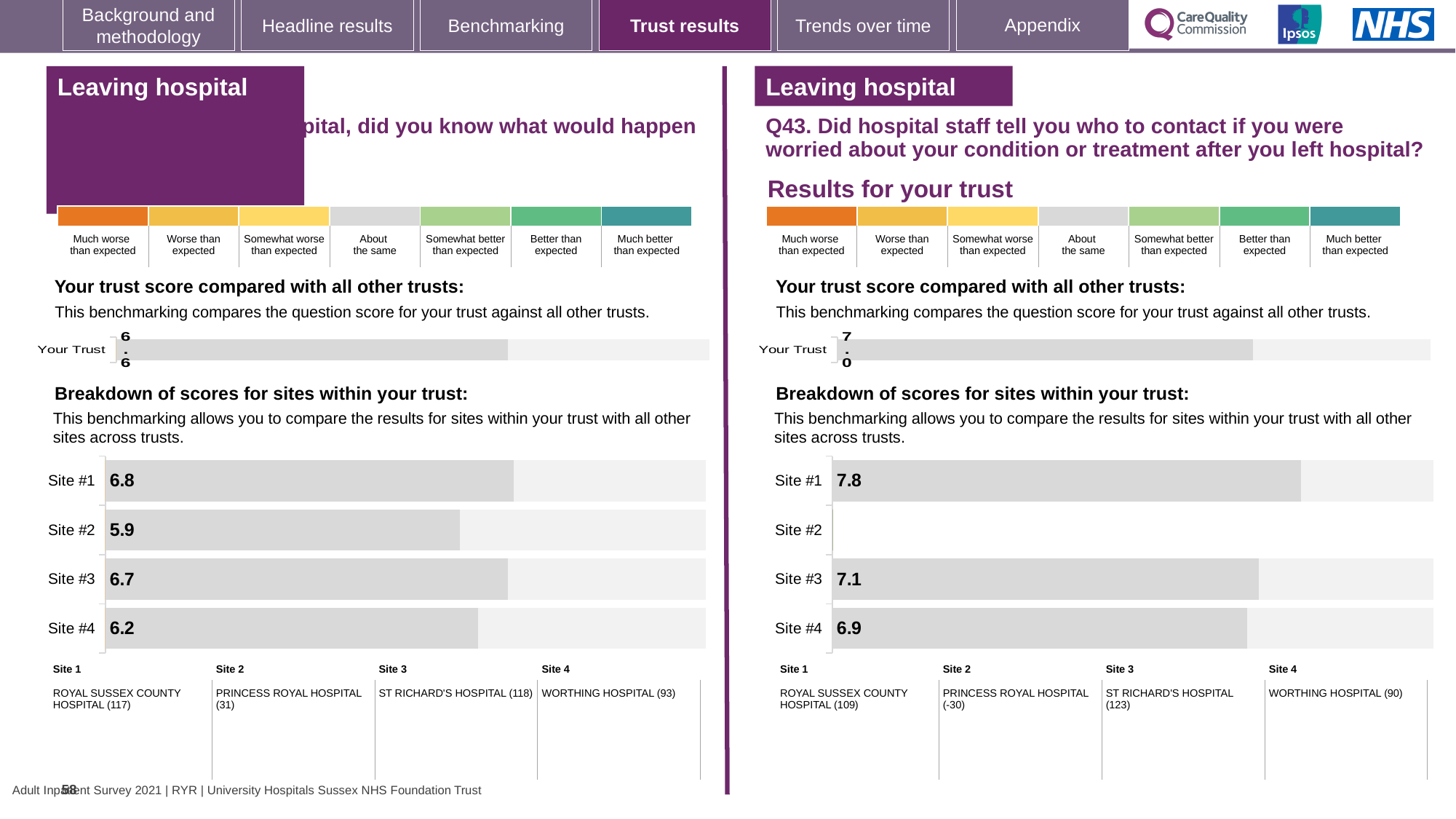
On the left-hand panel's 'Your trust score compared with all other trusts' chart, what is the score for Your Trust? 6.6 On the left-hand panel's site breakdown chart, which site has the highest score? Site #1 On the right-hand panel (Q43) site breakdown chart, which site has the highest score? Site #1 What type of chart is used for the site breakdown on the right-hand panel (Q43)? Bar chart On the right-hand panel (Q43) site breakdown chart, which is larger: the score for Site #3 or Site #4? Site #3 On the left-hand panel's site breakdown chart, what is the difference between the scores for Site #1 and Site #2? 0.9 On the right-hand panel (Q43) site breakdown chart, what is the difference between the scores for Site #1 and Site #4? 0.9 On the left-hand panel's site breakdown chart, which site has the lowest score? Site #2 How many sites are listed on the left-hand panel's site breakdown chart? 4 On the right-hand panel (Q43), what is the score for Your Trust in the 'Your trust score compared with all other trusts' chart? 7.0 On the left-hand panel's 'Breakdown of scores for sites within your trust' chart, what is the score for Site #1? 6.8 On the right-hand panel (Q43) site breakdown chart, what is the score for Site #3? 7.1